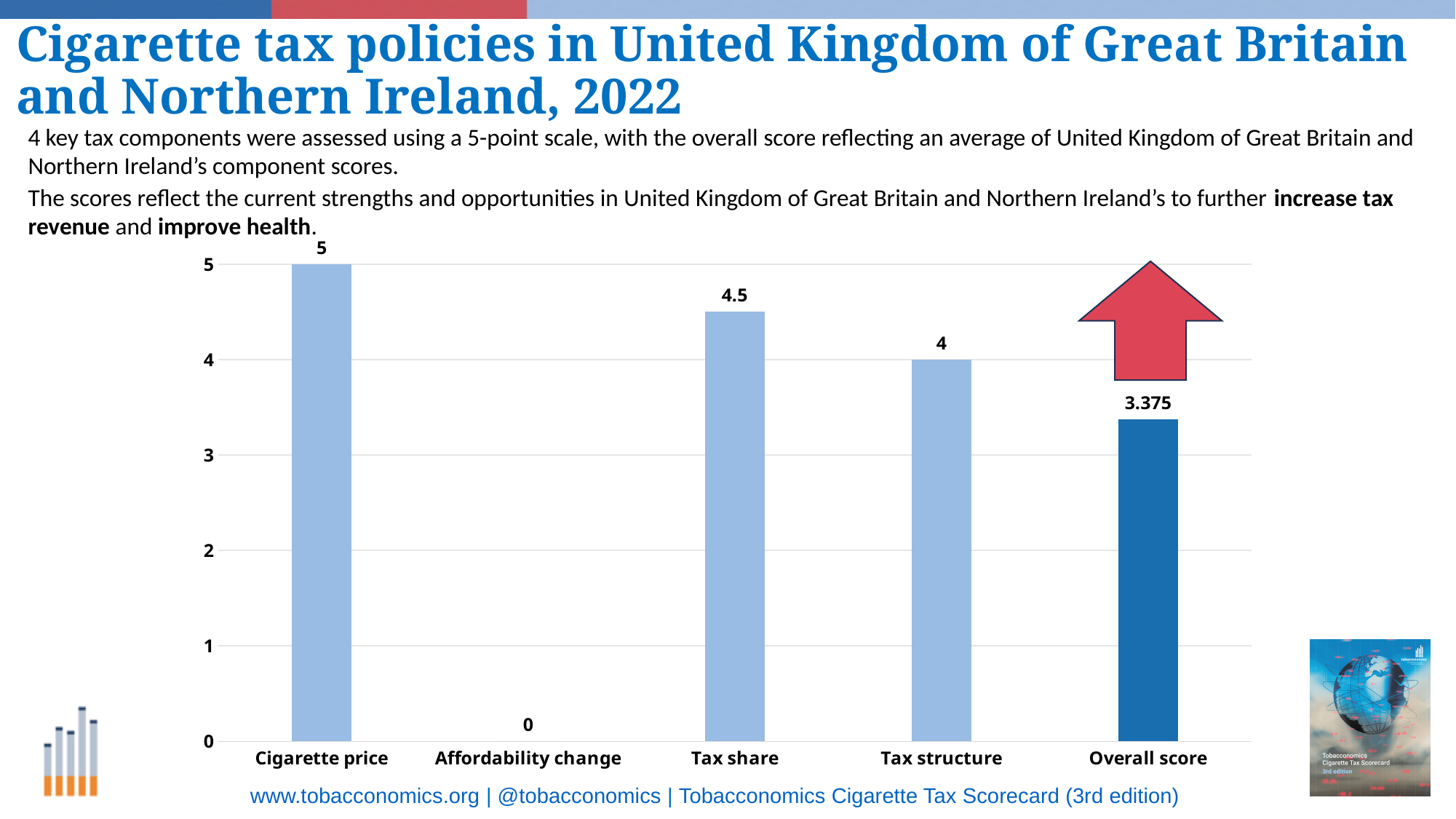
What is the value for Cigarette price? 5 What is the difference between the values for Cigarette price and Tax share? 0.5 What kind of chart is shown on the slide? bar chart What is the value for Affordability change? 0 Which is larger, the value for Tax share or the value for Tax structure? Tax share What is the Overall score? 3.375 Is the Overall score greater or less than 3? greater What is the value for Tax structure? 4 Which category has the highest value? Cigarette price What is the value for Tax share? 4.5 Which category has the lowest value? Affordability change How many categories are shown on the x axis? 5